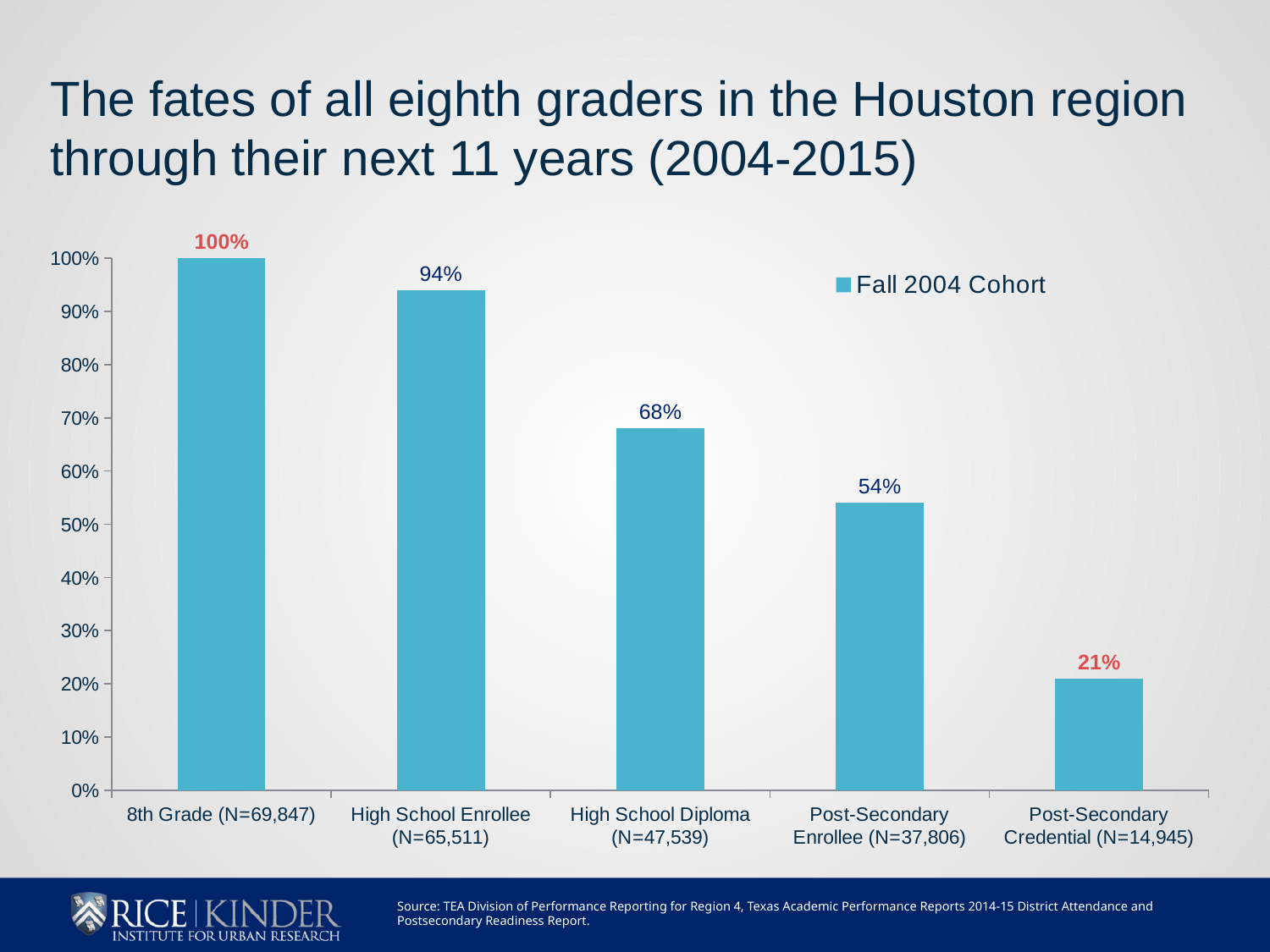
Which is larger, the value for High School Diploma or the value for Post-Secondary Enrollee? High School Diploma How many series does the legend list? 1 What kind of chart is shown on the slide? Bar chart Which category has the lowest value? Post-Secondary Credential (N=14,945) What is the difference between the values for High School Enrollee and High School Diploma? 26% How many categories are shown on the x axis? 5 What is the difference between the values for Post-Secondary Enrollee and Post-Secondary Credential? 33% Do the values rise or fall from left to right along the x axis? Fall What is the value for High School Diploma (N=47,539)? 68% What is the value for Post-Secondary Credential (N=14,945)? 21% Which category has the highest value? 8th Grade (N=69,847) What is the value for Post-Secondary Enrollee (N=37,806)? 54%